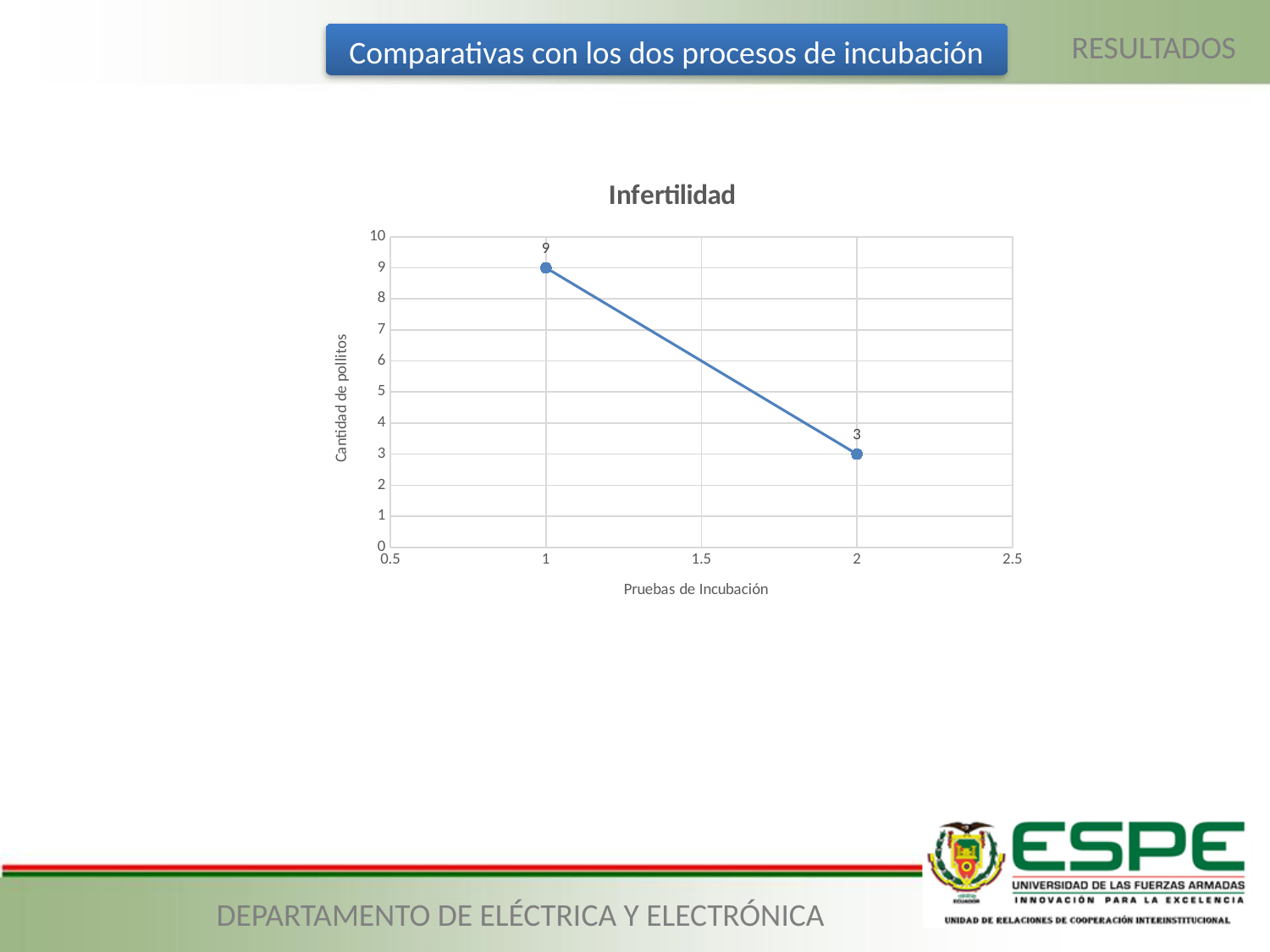
What is the title of the chart? Infertilidad How many data points are plotted in the Infertilidad chart? 2 Is the value at test 2 greater or less than 5? less Which incubation test has the higher infertility value, 1 or 2? 1 What is the label of the y axis? Cantidad de pollitos What is the value of Cantidad de pollitos at Prueba de Incubación 2 in the Infertilidad chart? 3 What is the value of Cantidad de pollitos at Prueba de Incubación 1 in the Infertilidad chart? 9 What is the difference between the infertility values at test 1 and test 2? 6 Do the values rise or fall from test 1 to test 2? fall Which incubation test has the lower infertility value, 1 or 2? 2 Is the value at test 1 larger or smaller than the value at test 2? larger What kind of chart is shown on the slide? line chart